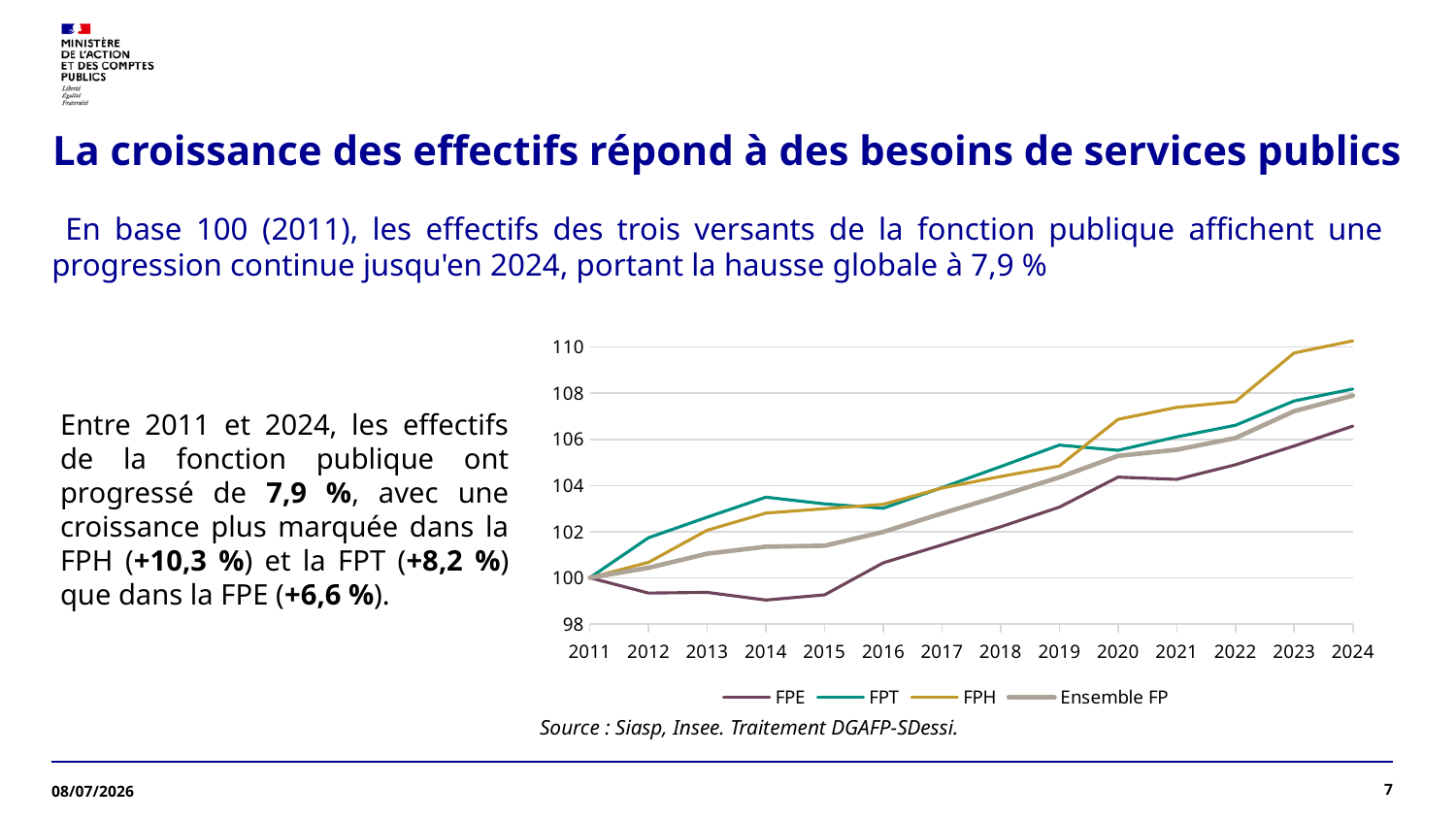
Which series has the lowest value in 2015? FPE How many series does the chart legend list? 4 What are the four series named in the chart legend? FPE, FPT, FPH, Ensemble FP How many years are plotted along the x axis of the chart? 14 In 2020, which series has the larger value, FPH or FPT? FPH Is the value for FPE in 2014 greater or less than 100? less Which series has the highest value in 2024? FPH What is the value of the FPE series in 2011? 100 Is the value for FPH in 2023 greater or less than 108? greater Does the FPH series rise or fall between 2011 and 2024? rise Which series has the lowest value in 2024? FPE What kind of chart is shown on the slide? line chart